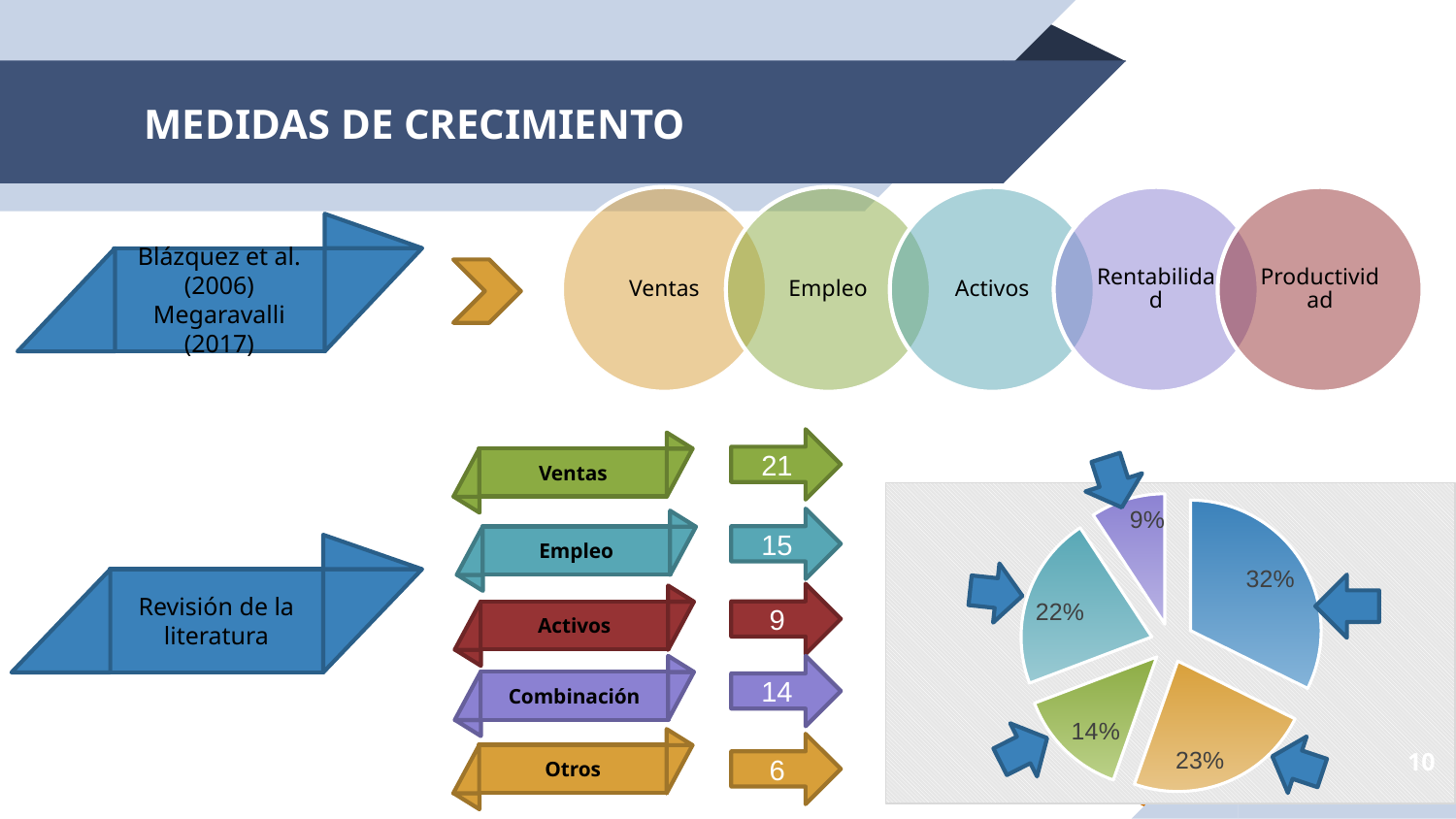
What percentage is shown on the orange slice of the pie chart? 23% What colour is the largest slice of the pie chart? blue What is the combined share of the 22% and 14% slices in the pie chart? 36% Is the largest slice of the pie chart greater or less than 30%? greater What is the largest percentage shown on the pie chart? 32% What kind of chart is shown on the right side of the slide? pie chart What is the difference between the largest slice (32%) and the second largest slice (23%) in the pie chart? 9% How many slices does the pie chart have? 5 What is the smallest percentage shown on the pie chart? 9% What percentage is shown on the green slice of the pie chart? 14% In the pie chart, which is larger: the teal slice or the green slice? the teal slice (22%) What percentage is shown on the purple slice of the pie chart? 9%